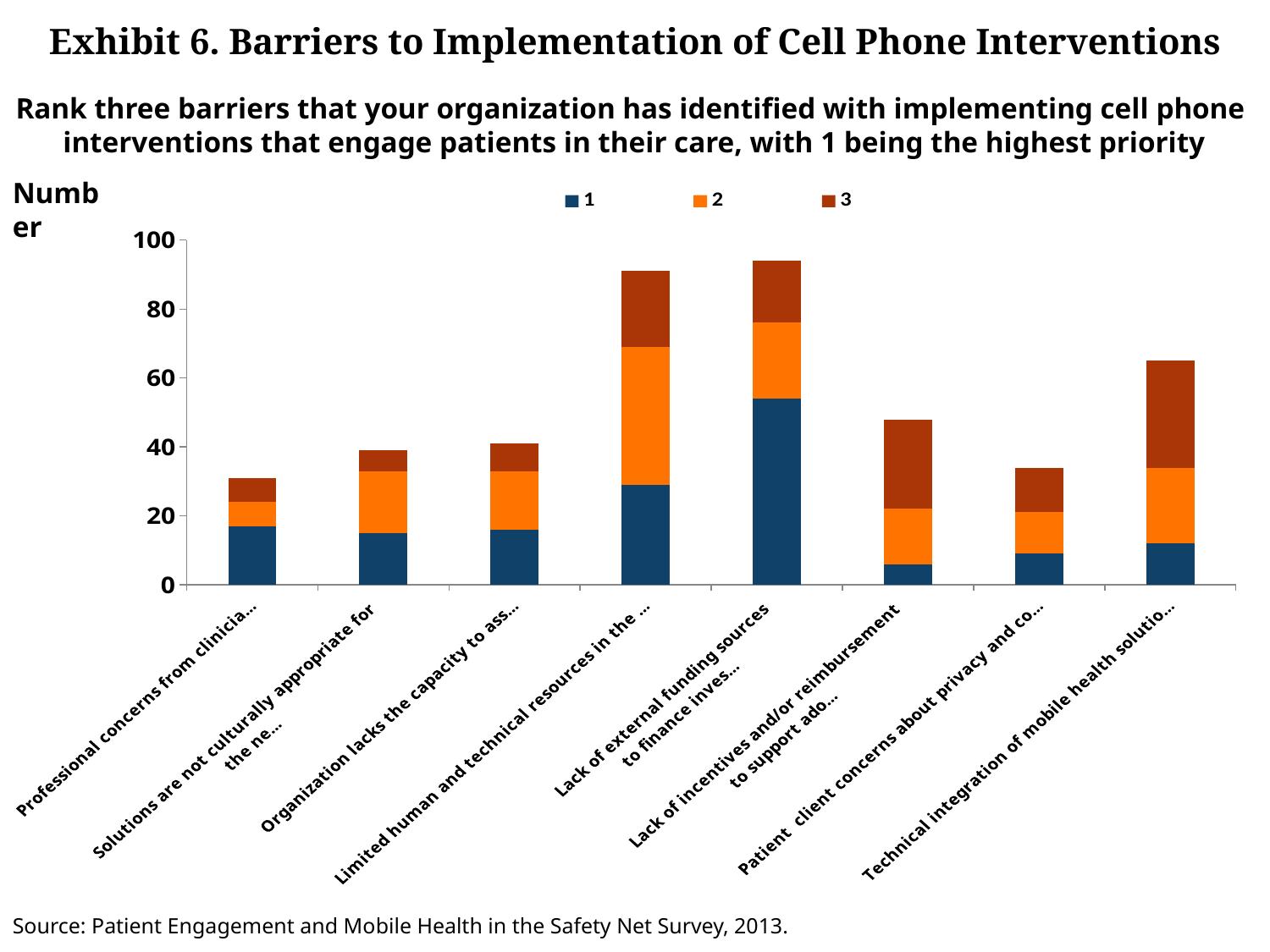
Which has the larger total stacked value: 'Technical integration of mobile health solutio...' or 'Lack of incentives and/or reimbursement'? Technical integration of mobile health solutio... What are the legend entries for the series? 1, 2, 3 Which barrier has the highest value for series 1 (ranked as highest priority)? Lack of external funding sources to finance inves... Which barrier has the lowest value for series 1? Lack of incentives and/or reimbursement to support ado... Is the total stacked value for 'Lack of external funding sources' greater or less than 80? greater How many series does the legend list? 3 Is the total stacked value for 'Professional concerns from clinicia...' greater or less than 40? less What is the label on the vertical axis? Number How many barrier categories are plotted along the x axis? 8 Is the series 1 value for 'Lack of external funding sources' greater or less than 40? greater Which has the larger series 1 value: 'Limited human and technical resources' or 'Solutions are not culturally appropriate'? Limited human and technical resources What kind of chart is shown on the slide? Stacked bar chart